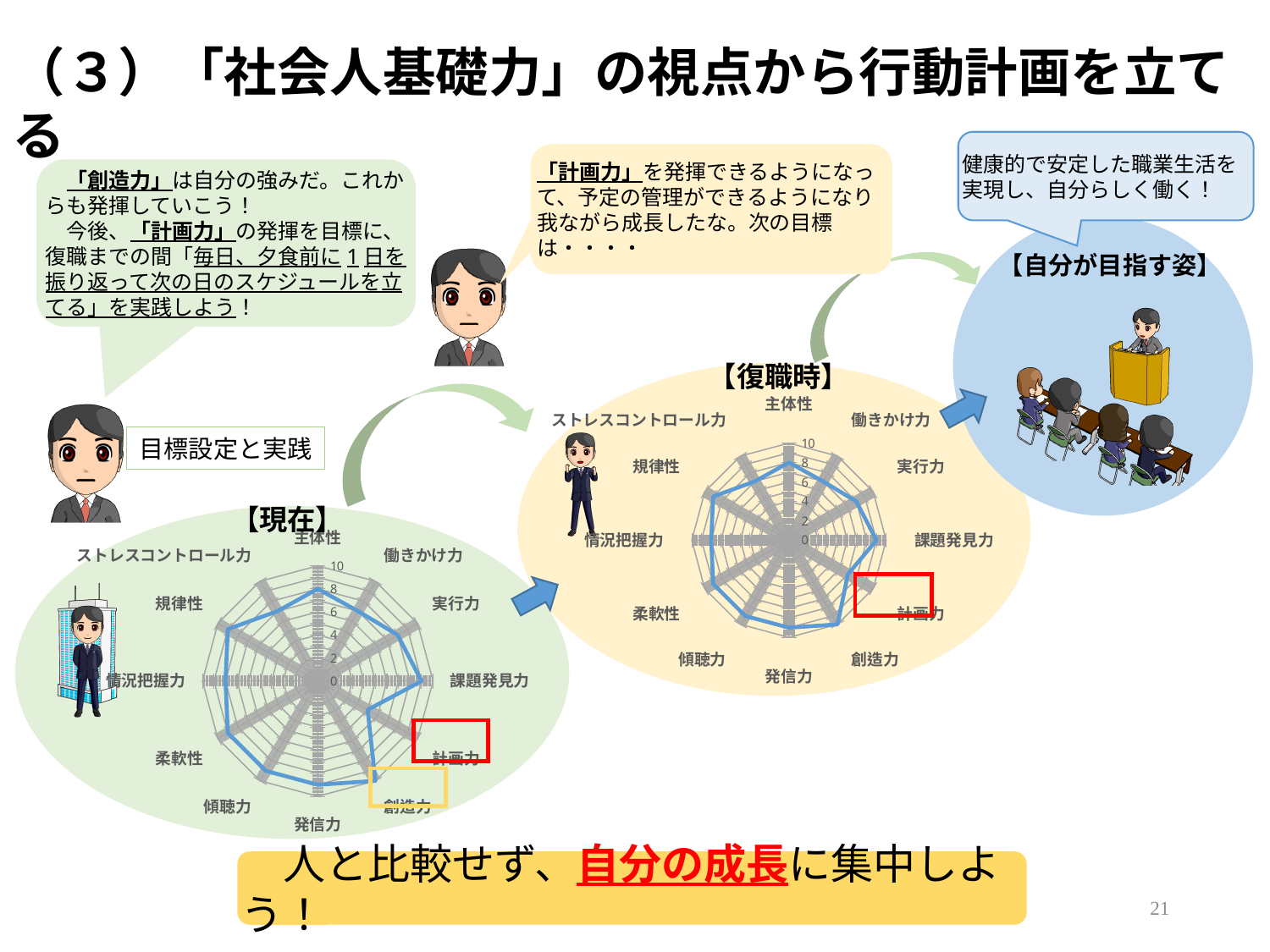
What kind of chart is the 【復職時】 chart on the right? radar chart What kind of chart is the 【現在】 chart on the left? radar chart In the 【現在】 chart, which category is highlighted with a red box? 計画力 How many categories (axes) does the 【現在】 radar chart have? 12 In the 【復職時】 chart, is the value for 主体性 greater or less than 4? greater How many categories (axes) does the 【復職時】 radar chart have? 12 In the 【現在】 chart, is the value for 創造力 greater or less than 6? greater In the 【復職時】 chart, is the value for 計画力 greater or less than 4? greater What is the maximum value shown on the axis scale of the 【現在】 radar chart? 10